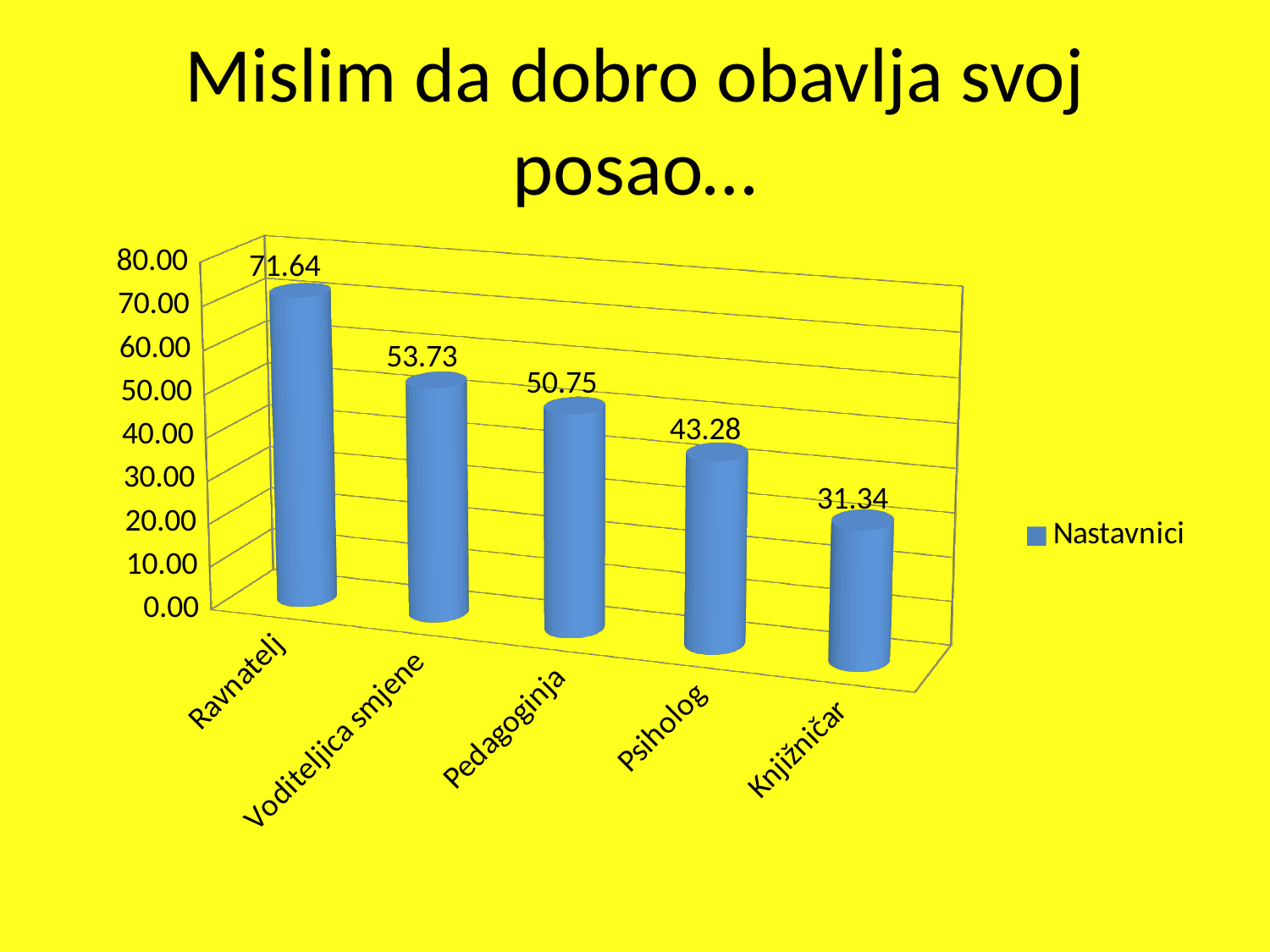
Which category has the lowest value? Knjižničar What is the value for Psiholog? 43.28 Which is larger, the value for Voditeljica smjene or the value for Psiholog? Voditeljica smjene What series name does the legend list? Nastavnici What is the value for Pedagoginja? 50.75 What is the value for Voditeljica smjene? 53.73 What kind of chart is shown on the slide? Bar chart How many categories are shown on the x axis? 5 Which category has the highest value? Ravnatelj What is the value for Knjižničar? 31.34 What is the difference between the values for Ravnatelj and Knjižničar? 40.30 What is the value for Ravnatelj? 71.64